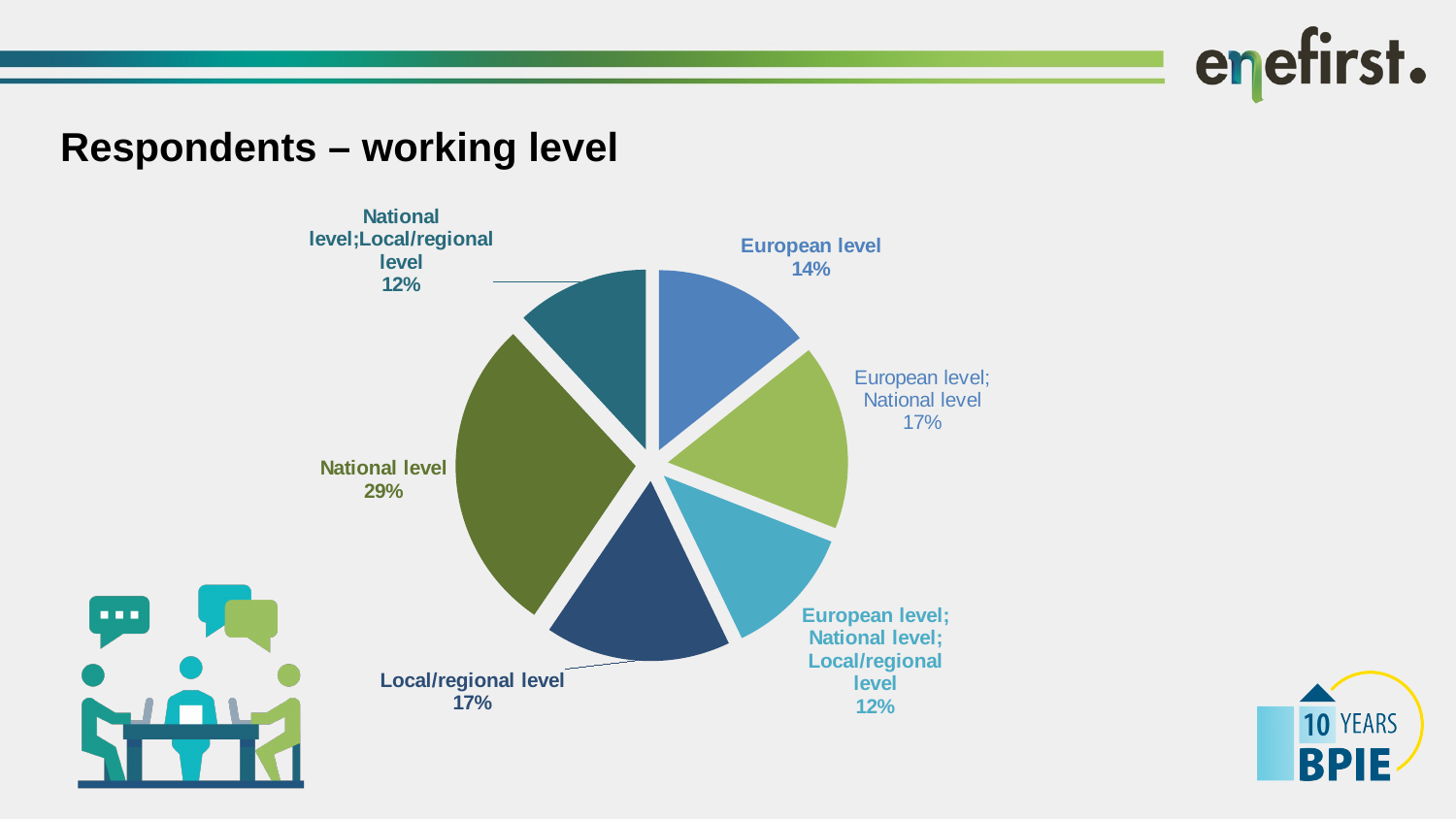
What share of respondents work at the Local/regional level? 17% What kind of chart is shown on the slide? Pie chart What share of respondents work at the National level? 29% What is the combined share of National level and Local/regional level respondents? 46% Which working level has the largest share of respondents? National level What share of respondents work at the European level only? 14% What is the title of the slide containing the pie chart? Respondents – working level What share of respondents work at the European level; National level; Local/regional level? 12% What share of respondents work at the European level; National level? 17% Which is larger: the share for National level or the share for Local/regional level? National level What is the difference in share between National level and European level? 15% How many slices does the pie chart have? 6